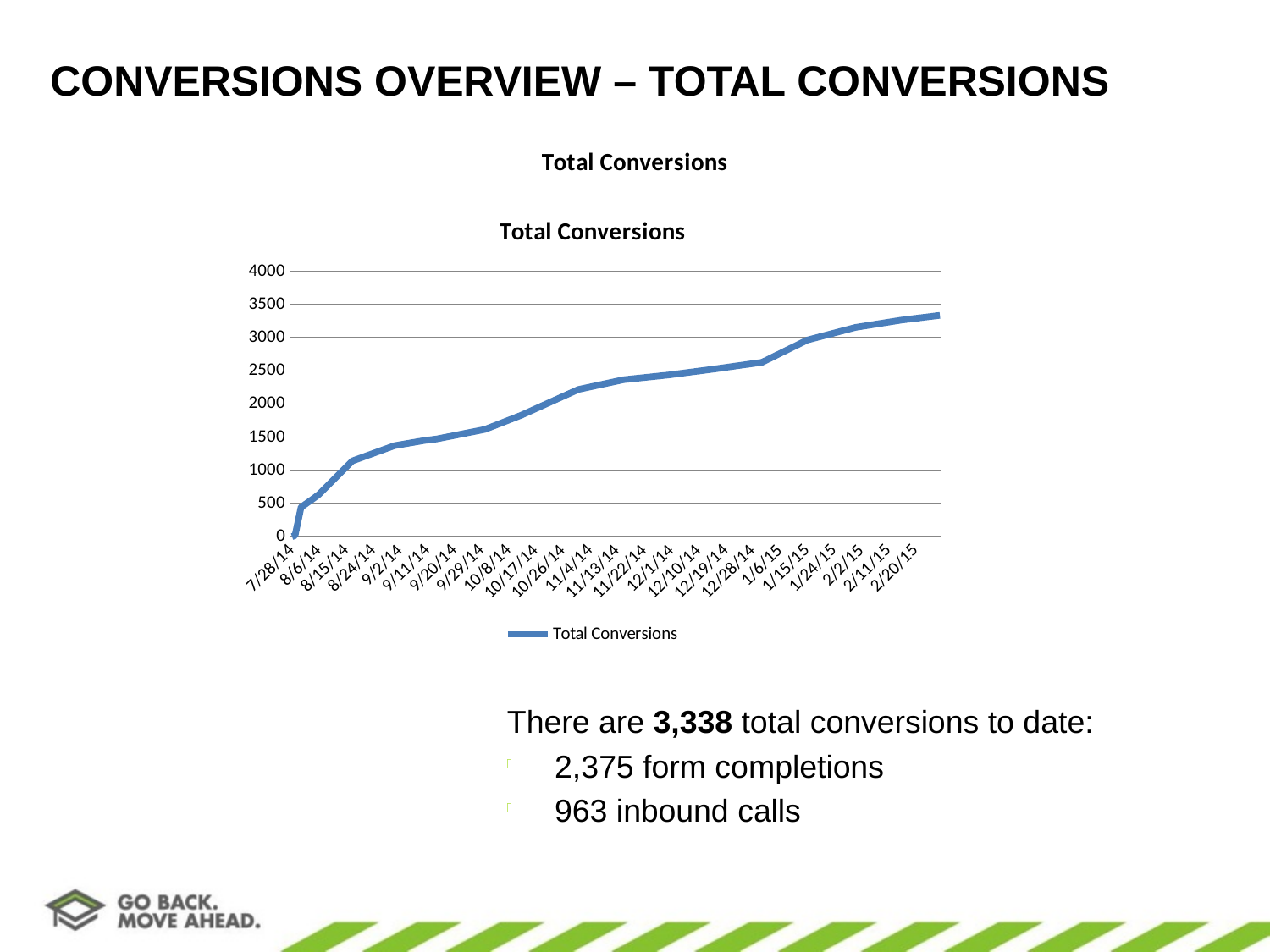
What kind of chart is shown on the slide? line chart How many series does the legend of the Total Conversions chart list? 1 Is the value for 2/20/15 greater or less than 3500? less What is the name of the series shown in the legend? Total Conversions Which date has the lowest value in the Total Conversions chart? 7/28/14 What is the value for 7/28/14 in the Total Conversions chart? 0 Do the values in the Total Conversions chart rise or fall from 7/28/14 to 2/20/15? rise Which is larger, the value for 9/20/14 or the value for 1/24/15? 1/24/15 How many dates are labelled along the x axis of the Total Conversions chart? 24 Is the value for 11/4/14 greater or less than 2000? greater